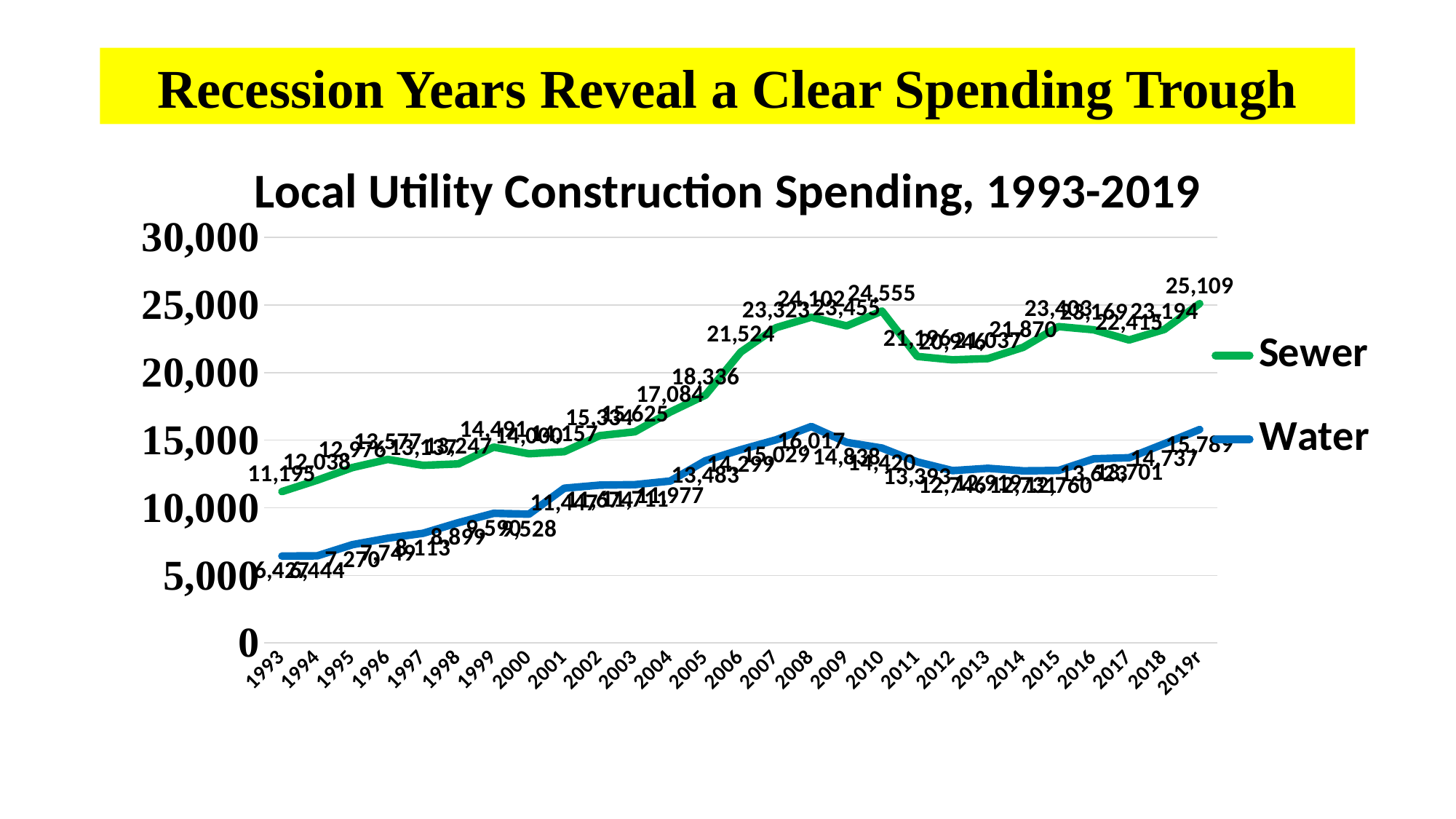
Which series has the larger value in 2010, Sewer or Water? Sewer In 2008, how much higher is the Sewer value than the Water value? 8,085 Is the Water value for 2013 greater or less than 15,000? less What is the Sewer value for 1993? 11,195 In which year does the Sewer series reach its highest value? 2019r What is the Sewer value for 2019r? 25,109 What is the difference between the Sewer value in 2019r and in 1993? 13,914 In which year is the Sewer value lowest? 1993 What kind of chart is shown on the slide? Line chart What is the Water value for 2008? 16,017 How many series does the legend list? 2 In which year does the Water series reach its highest value? 2008